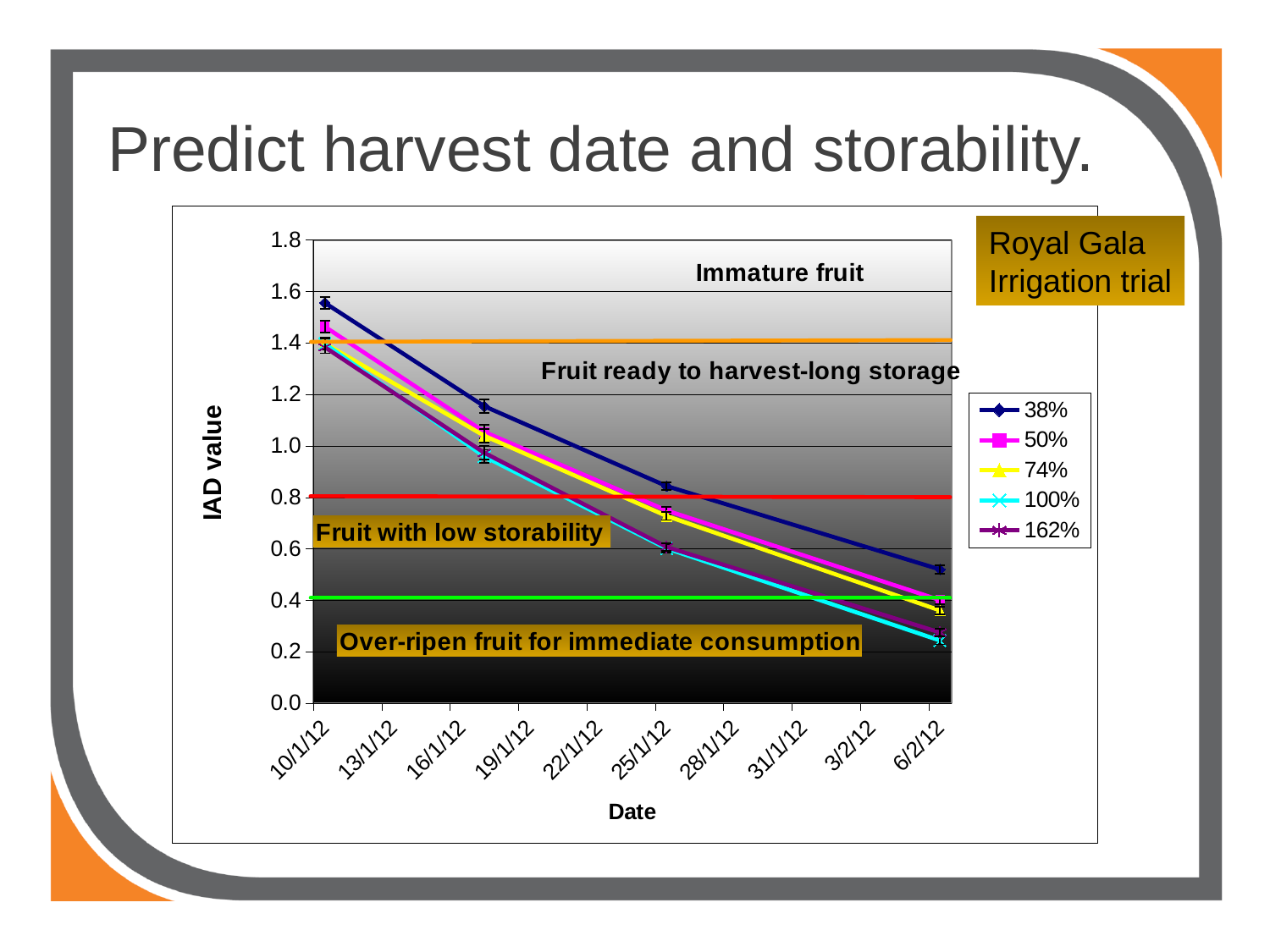
Is the IAD value for the 38% series on 6/2/12 greater or less than 0.4? greater On 6/2/12, which series has the larger IAD value, 38% or 100%? 38% What kind of chart is shown on the slide? line chart Is the IAD value for the 38% series on 10/1/12 greater or less than 1.4? greater How many data points are plotted for each series? 4 Is the IAD value for the 100% series on 6/2/12 greater or less than 0.4? less Which series has the highest IAD value on 10/1/12? 38% What is the title of the x axis? Date What is the title of the y axis? IAD value Do the IAD values for the 38% series rise or fall over time along the x axis? fall How many series does the legend list? 5